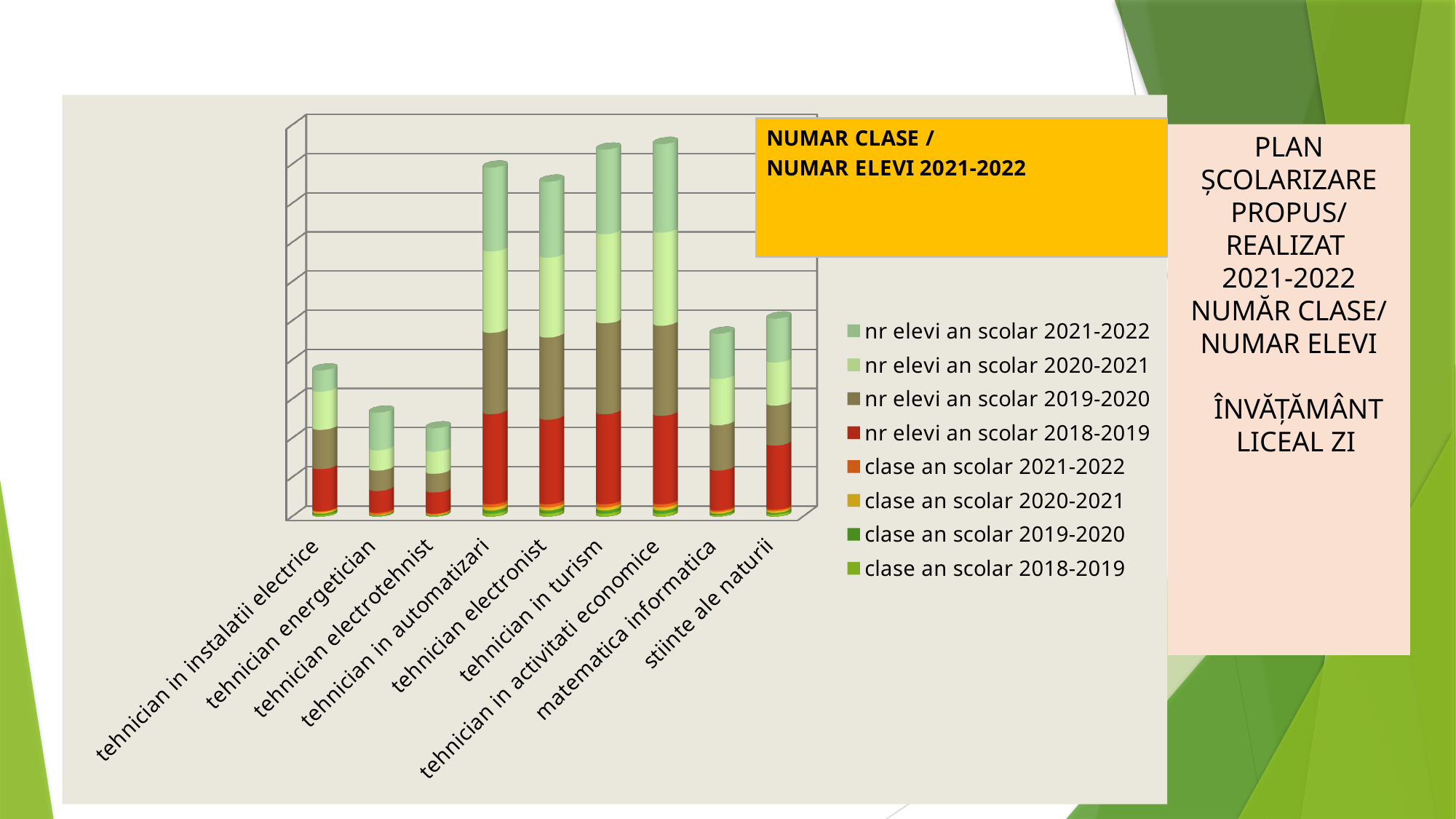
Which category has the shortest stacked bar in the chart? tehnician electrotehnist How many series does the chart's legend list? 8 What is the title shown in the yellow box on the chart? NUMAR CLASE / NUMAR ELEVI 2021-2022 Which stacked bar is taller: matematica informatica or tehnician electrotehnist? matematica informatica How many categories (specializations) are shown along the x axis of the chart? 9 Which stacked bar is taller: tehnician in automatizari or tehnician in instalatii electrice? tehnician in automatizari Which legend entry is shown in red in the chart? nr elevi an scolar 2018-2019 Which stacked bar is taller: tehnician energetician or tehnician in turism? tehnician in turism What kind of chart is shown on the slide? Stacked bar chart